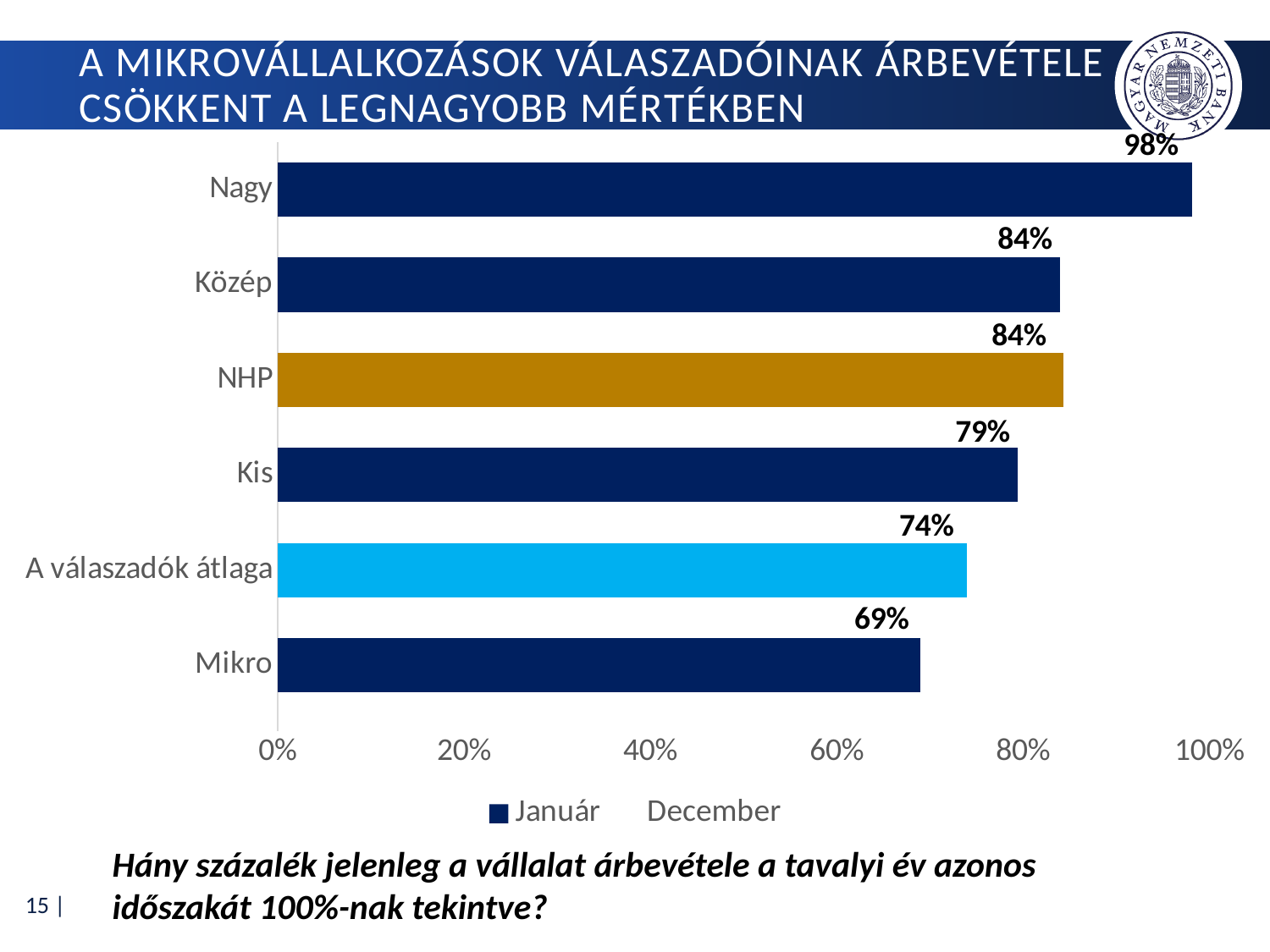
What is the difference between the values for Nagy and Mikro? 29% What kind of chart is shown on the slide? bar chart What is the value for Nagy? 98% What is the value for A válaszadók átlaga? 74% How many entries does the legend list? 2 Which is larger, the value for Kis or the value for Mikro? Kis What is the value for Kis? 79% Is the value for Közép greater or less than 80%? greater What is the value for Mikro? 69% How many categories are shown on the chart? 6 Which category has the highest value? Nagy Which category has the lowest value? Mikro